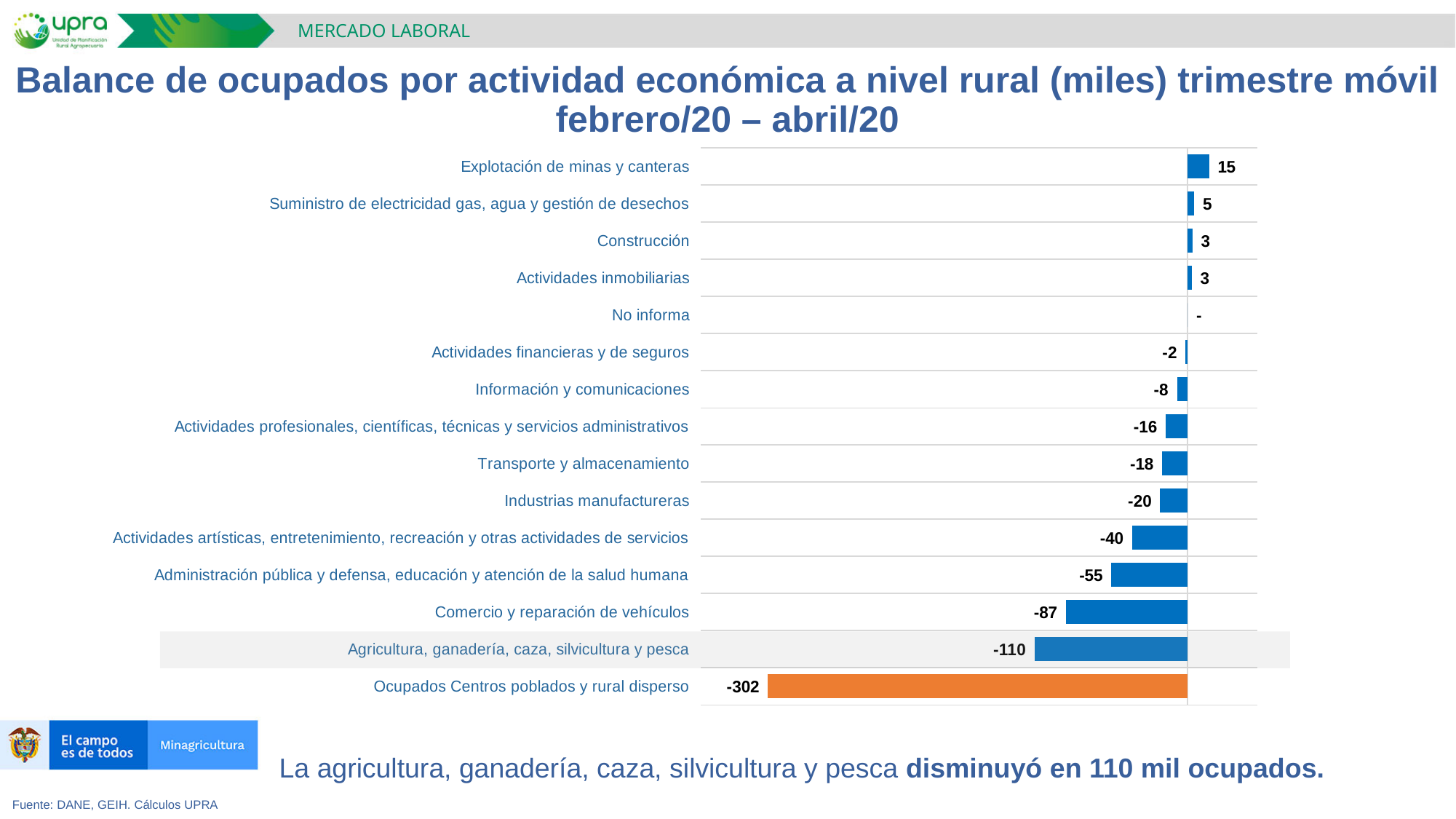
What is the value for Explotación de minas y canteras? 15 What is the value for Transporte y almacenamiento? -18 Which category has the highest value? Explotación de minas y canteras Which category has the lowest value? Ocupados Centros poblados y rural disperso How many categories are shown in the chart? 15 What is the value for Ocupados Centros poblados y rural disperso? -302 What is the difference between the values for Comercio y reparación de vehículos and Agricultura, ganadería, caza, silvicultura y pesca? 23 Which category's bar is coloured orange? Ocupados Centros poblados y rural disperso What is the value for Comercio y reparación de vehículos? -87 What kind of chart is shown on the slide? Bar chart What is the value for Agricultura, ganadería, caza, silvicultura y pesca? -110 Which is larger, the value for Industrias manufactureras or the value for Actividades artísticas, entretenimiento, recreación y otras actividades de servicios? Industrias manufactureras